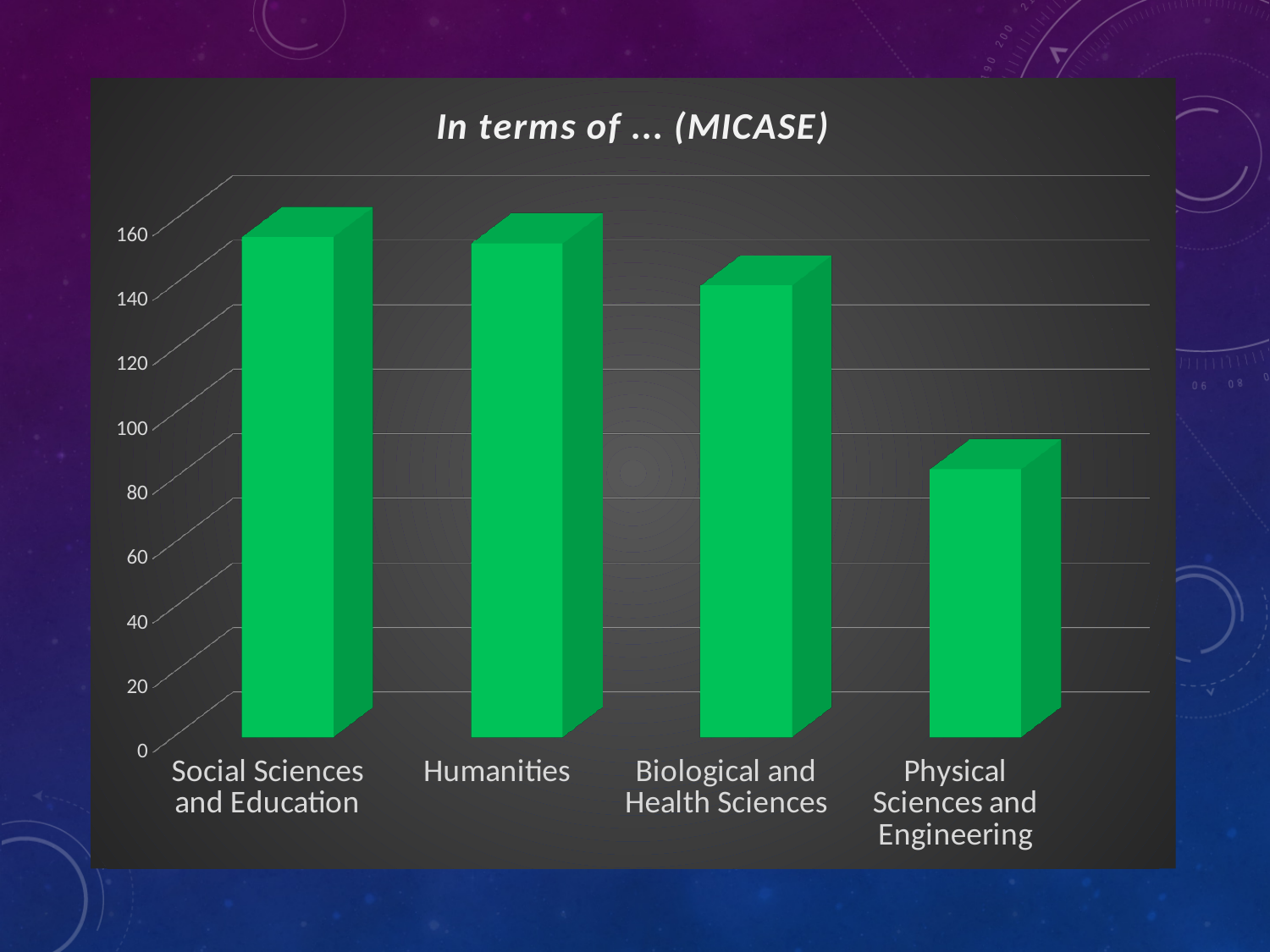
Is the value for Physical Sciences and Engineering greater or less than 100? less How many categories are shown on the x axis of the chart? 4 Which is larger, the value for Humanities or the value for Biological and Health Sciences? Humanities Is the value for Biological and Health Sciences greater or less than 120? greater Is the value for Humanities greater or less than 140? greater What is the title of the chart? In terms of ... (MICASE) Which category has the lowest value in the chart? Physical Sciences and Engineering Do the values rise or fall moving from left to right along the x axis? fall What kind of chart is shown on the slide? bar chart Which is larger, the value for Biological and Health Sciences or the value for Physical Sciences and Engineering? Biological and Health Sciences